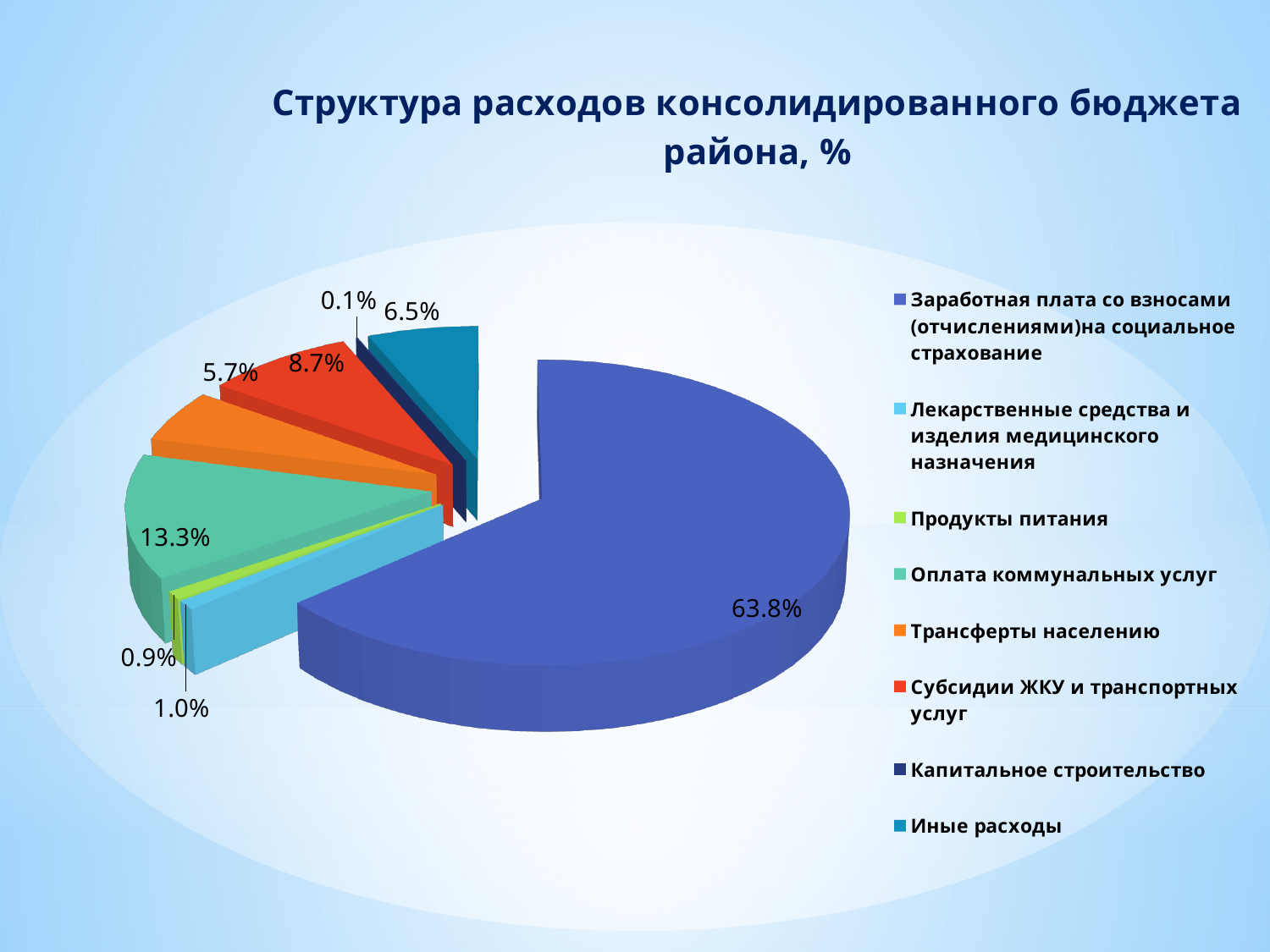
What type of chart is shown on the slide? Pie chart What share of expenditures is for Оплата коммунальных услуг? 13.3% Which category has the largest share of expenditures? Заработная плата со взносами (отчислениями) на социальное страхование What share of expenditures is for Иные расходы? 6.5% Which is larger: the share for Иные расходы or the share for Трансферты населению? Иные расходы How many categories does the legend list? 8 What is the title of the chart? Структура расходов консолидированного бюджета района, % What share of expenditures is for Трансферты населению? 5.7% What is the difference between the shares for Оплата коммунальных услуг and Субсидии ЖКУ и транспортных услуг? 4.6% Which category has the smallest share of expenditures? Капитальное строительство What share of expenditures is for Заработная плата со взносами (отчислениями) на социальное страхование? 63.8% What share of expenditures is for Субсидии ЖКУ и транспортных услуг? 8.7%